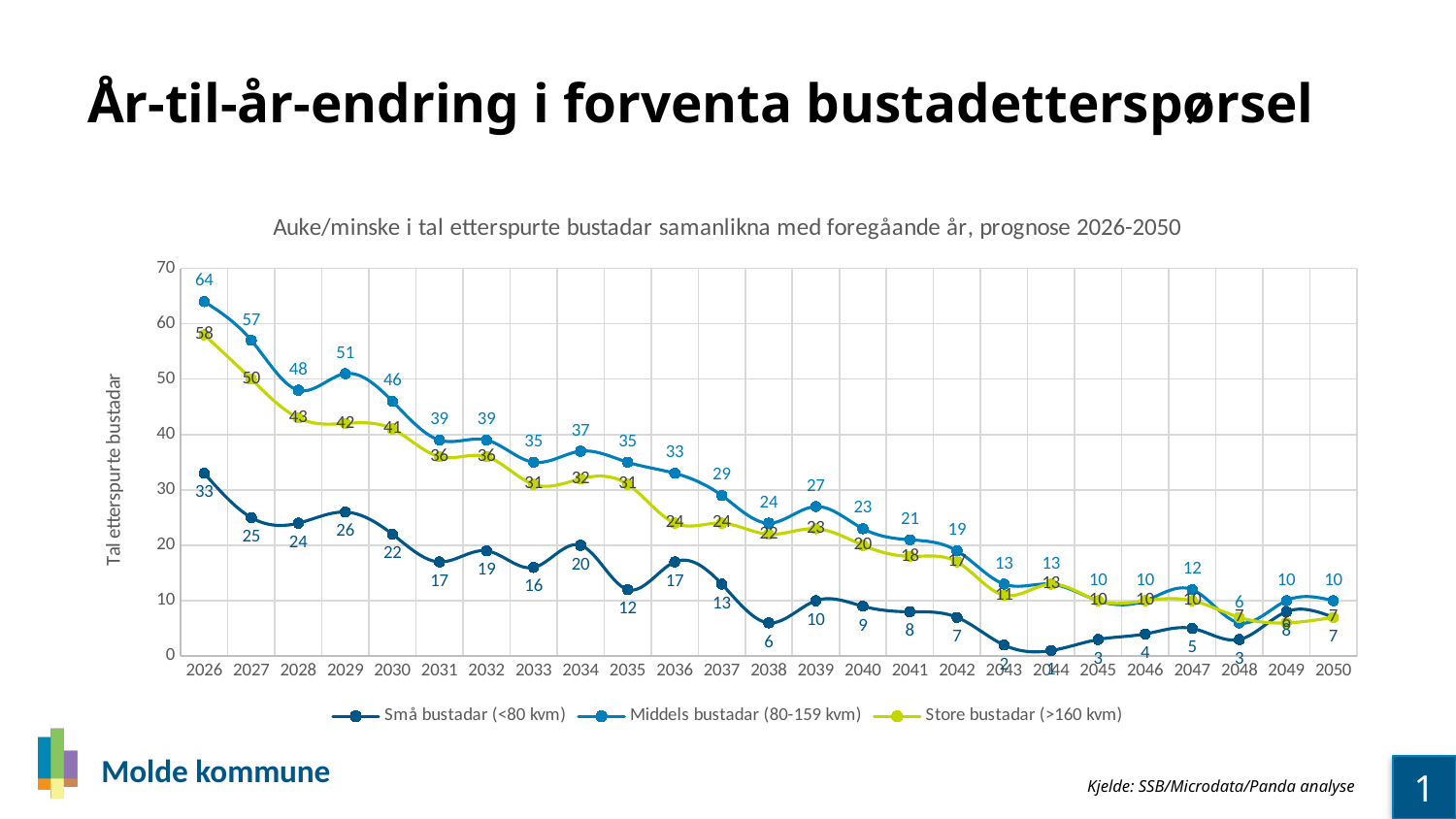
What is the value for Store bustadar (>160 kvm) in 2027? 50 What is the value for Middels bustadar (80-159 kvm) in 2026? 64 In 2030, which is larger: Middels bustadar (80-159 kvm) or Store bustadar (>160 kvm)? Middels bustadar (80-159 kvm) How many years are plotted on the x axis? 25 What is the difference between Middels bustadar (80-159 kvm) and Små bustadar (<80 kvm) in 2026? 31 Do the values for Middels bustadar (80-159 kvm) generally rise or fall from 2026 to 2050? Fall In which year is the value for Middels bustadar (80-159 kvm) highest? 2026 What is the value for Små bustadar (<80 kvm) in 2026? 33 In which year is the value for Middels bustadar (80-159 kvm) lowest? 2048 What is the value for Små bustadar (<80 kvm) in 2038? 6 How many series does the legend list? 3 What kind of chart is shown on the slide? Line chart